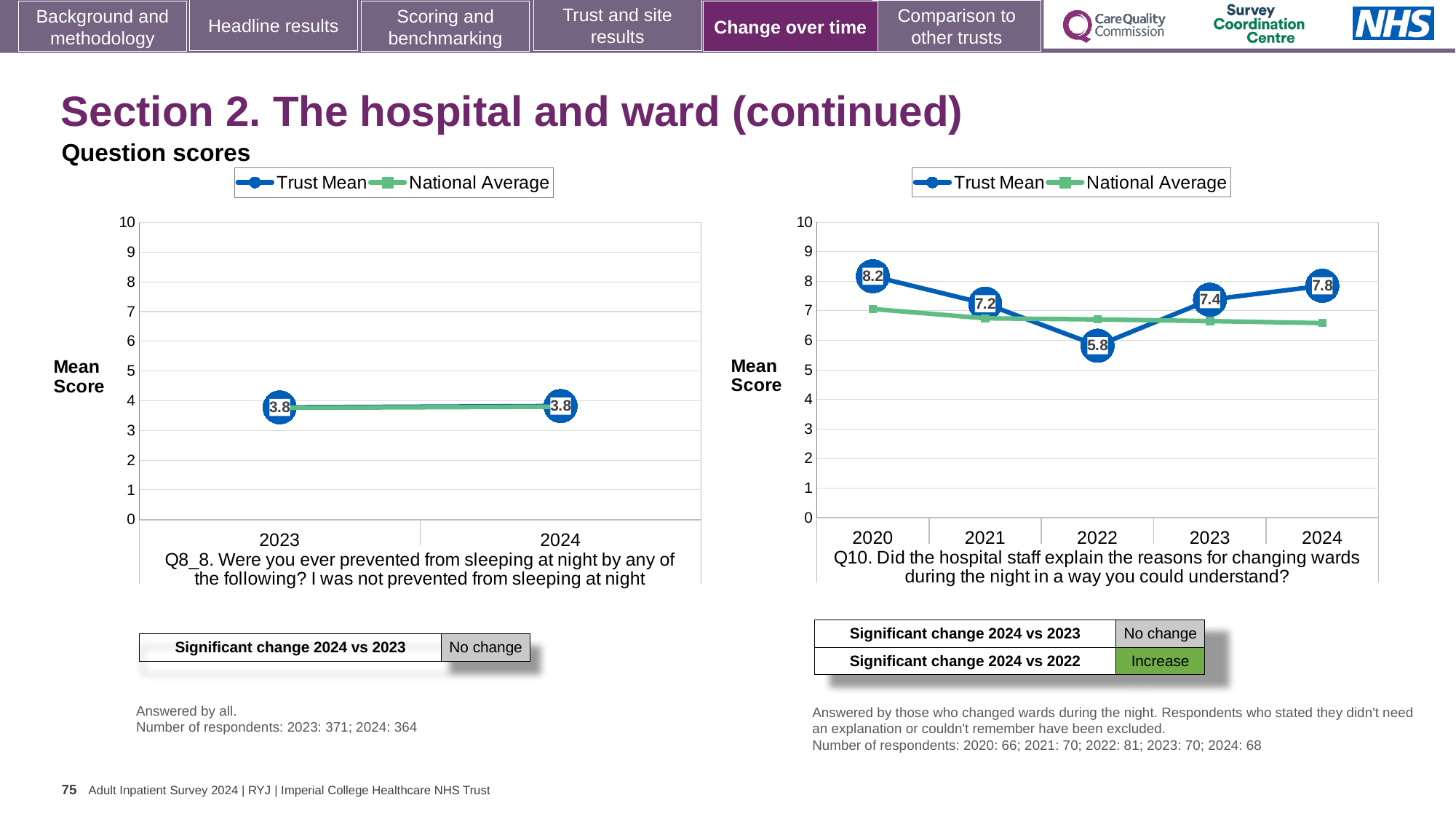
In the Q10 chart on the right, what is the Trust Mean for 2022? 5.8 In the Q10 chart on the right, what is the difference between the Trust Mean for 2020 and the Trust Mean for 2022? 2.4 What kind of chart is the Q10 chart on the right? Line chart In the Q10 chart on the right, what is the Trust Mean for 2024? 7.8 In the Q8_8 chart on the left, how many years are plotted on the x axis? 2 In the Q10 chart on the right, which year has the lowest Trust Mean? 2022 In the Q10 chart on the right, which year has the highest Trust Mean? 2020 In the Q8_8 chart on the left, what is the Trust Mean for 2023? 3.8 In the Q8_8 chart on the left, what is the Trust Mean for 2024? 3.8 In the Q8_8 chart on the left, is the Trust Mean for 2024 greater or less than 5? less In the Q10 chart on the right, is the Trust Mean higher in 2023 or in 2024? 2024 In the Q10 chart on the right, how many series does the legend list? 2